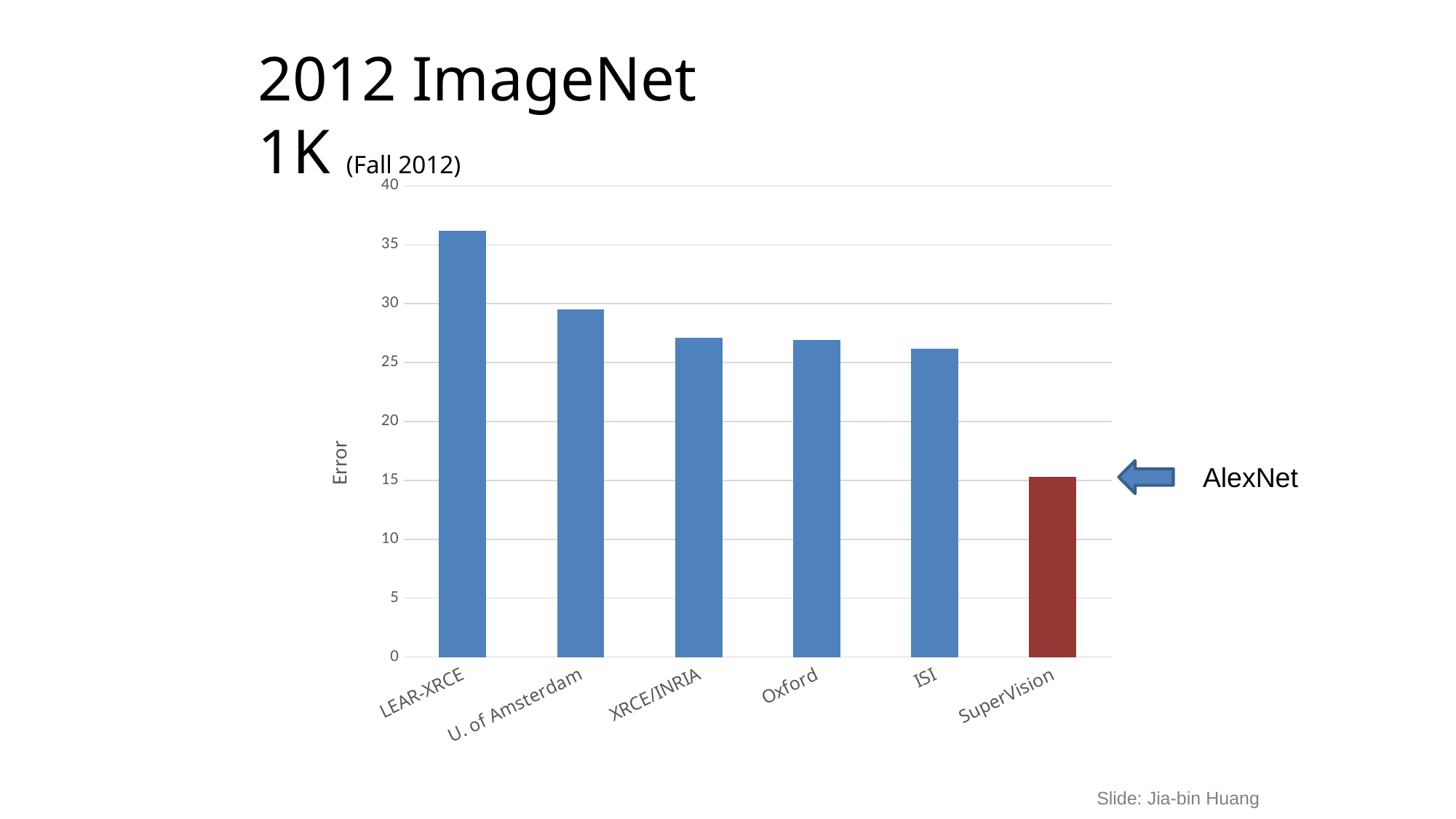
Which team has the highest error? LEAR-XRCE How many categories (teams) are plotted on the x axis? 6 Which has a lower error, ISI or SuperVision? SuperVision Do the error values rise or fall moving from left to right along the x axis? fall Is the error for U. of Amsterdam greater or less than 25? greater Is the error for SuperVision greater or less than 20? less Is the error for ISI greater or less than 30? less Which team's bar is labelled with the arrow annotation 'AlexNet'? SuperVision Which team has the lowest error? SuperVision Which has a higher error, LEAR-XRCE or U. of Amsterdam? LEAR-XRCE What kind of chart is shown on the slide? bar chart